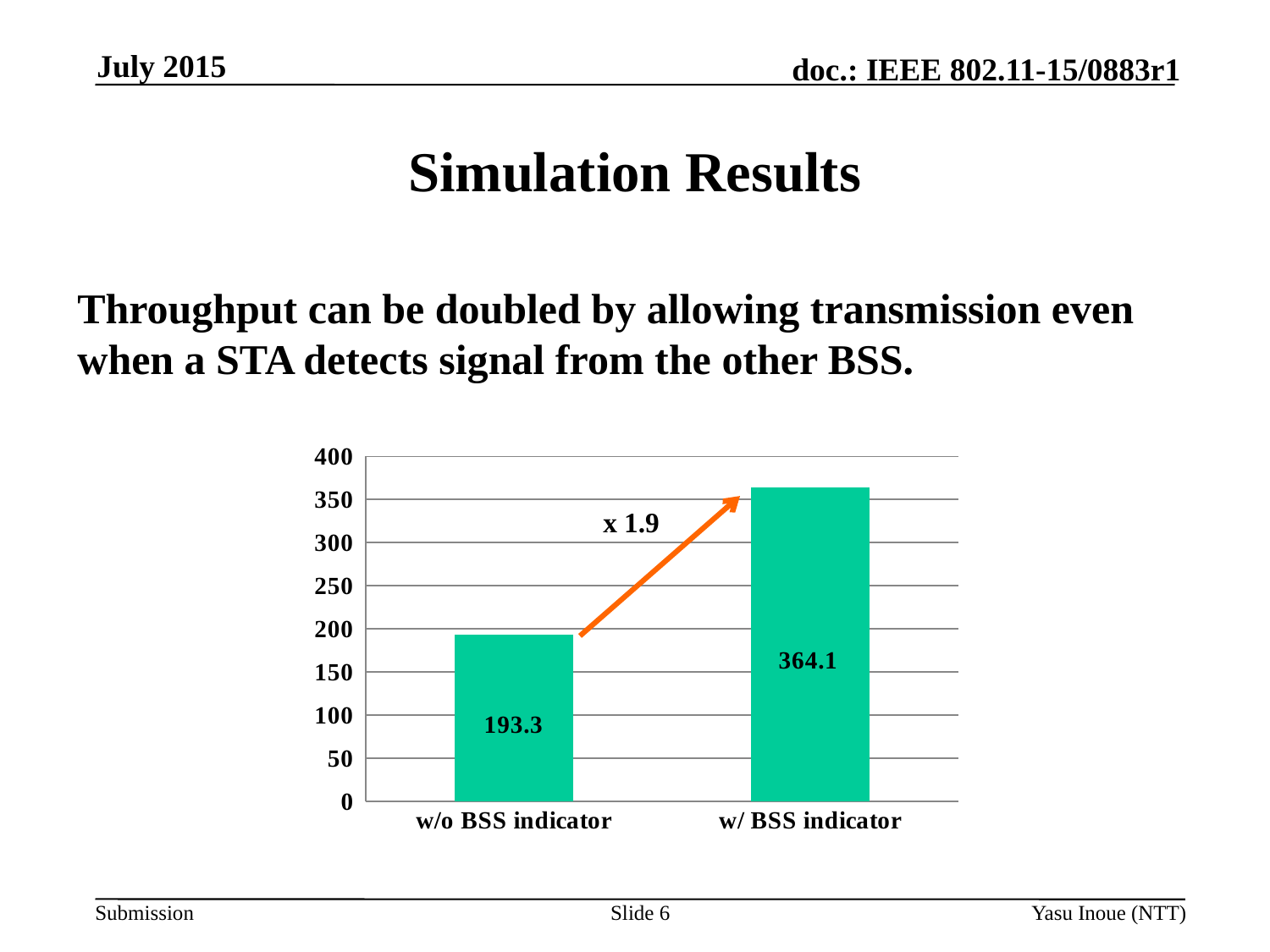
What multiplier is written next to the arrow between the two bars? x 1.9 Which is larger, the value for w/o BSS indicator or the value for w/ BSS indicator? w/ BSS indicator How many categories are shown on the x axis? 2 What is the value for w/o BSS indicator? 193.3 What kind of chart is shown on the slide? bar chart What is the value for w/ BSS indicator? 364.1 Is the value for w/o BSS indicator greater or less than 200? less Which category has the highest value? w/ BSS indicator Which category has the lowest value? w/o BSS indicator What is the difference between the values for w/ BSS indicator and w/o BSS indicator? 170.8 Is the value for w/ BSS indicator greater or less than 350? greater What is the maximum value shown on the y axis? 400